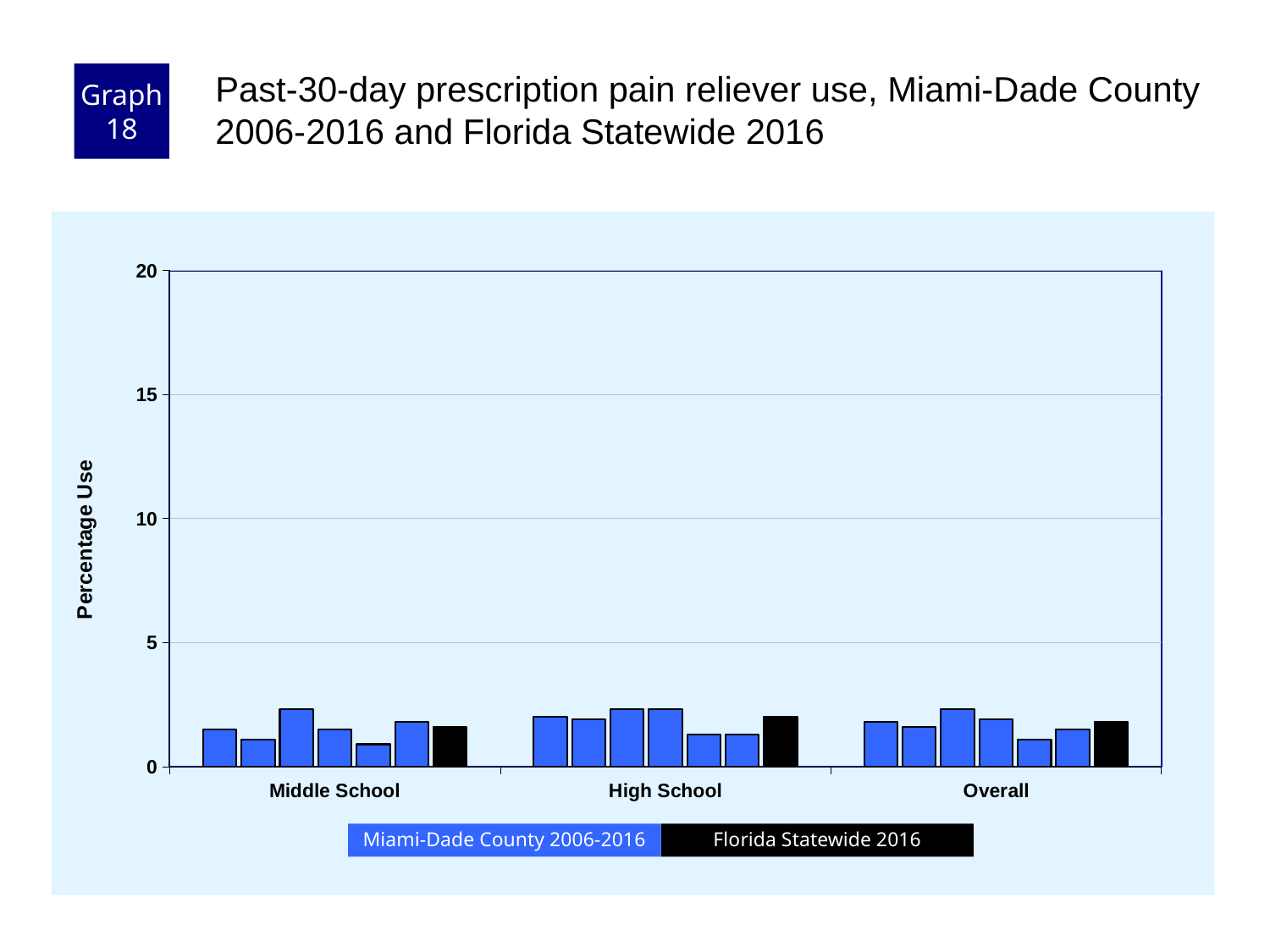
How many series does the chart's legend list? 2 How many categories are shown on the x axis of the chart? 3 Is the value for Florida Statewide 2016 in the Middle School group greater or less than 5? less Are any of the Miami-Dade County 2006-2016 bars in the High School group greater or less than 10? less Which series is shown in black in the chart's legend? Florida Statewide 2016 What kind of chart is shown on the slide? bar chart What is the label on the y axis of the chart? Percentage Use Is the value for Florida Statewide 2016 in the High School group greater or less than 5? less What is the highest value shown on the y axis of the chart? 20